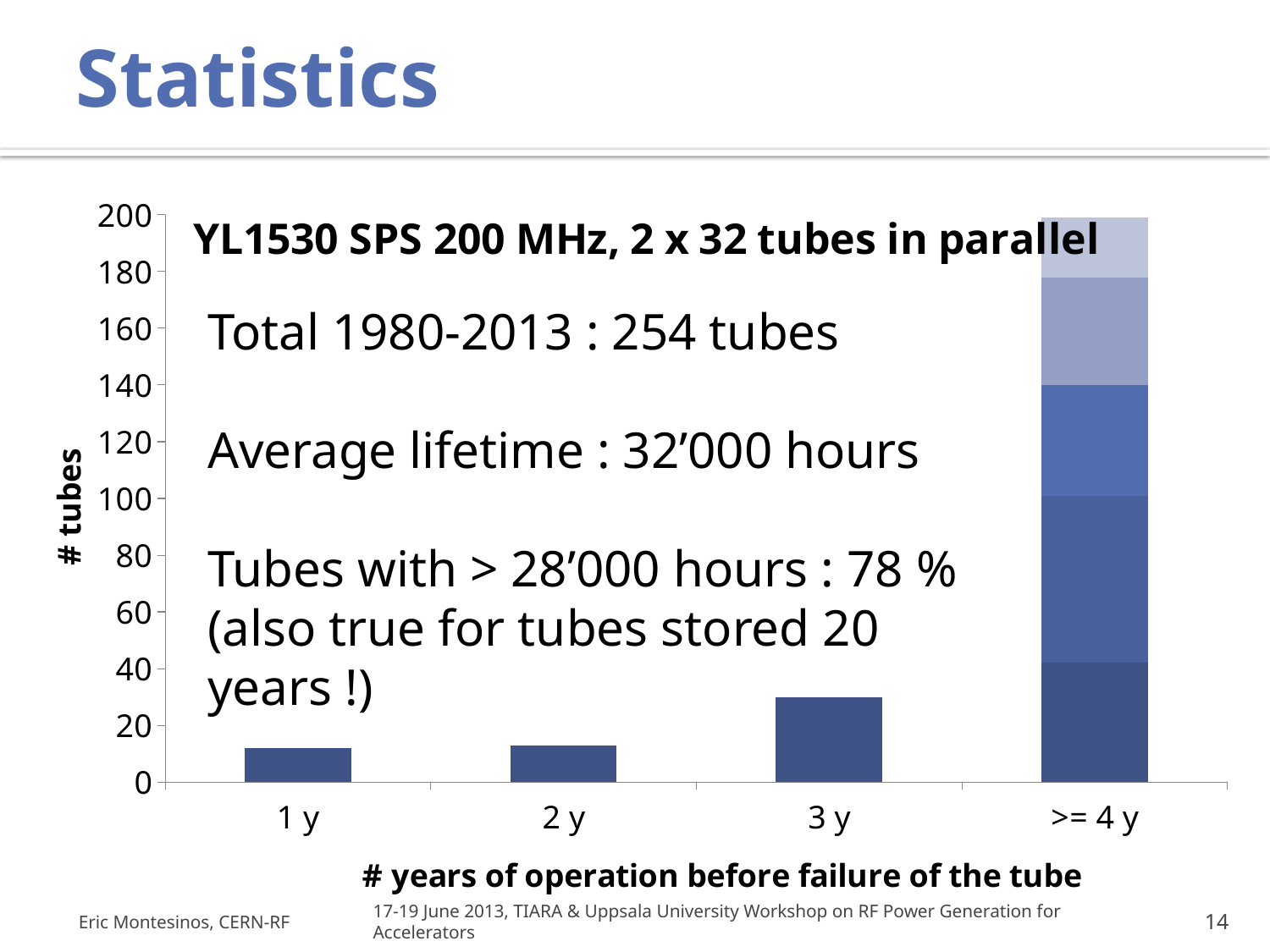
What kind of chart is shown on the slide? bar chart Is the value for >= 4 y greater or less than 180? greater Do the values rise or fall from 1 y to >= 4 y along the x axis? rise Which is larger, the value for 3 y or the value for 1 y? 3 y Which category has the highest number of tubes? >= 4 y Is the value for 2 y greater or less than 20? less How many categories are shown on the x axis of the chart? 4 What is the label of the x axis of the chart? # years of operation before failure of the tube Is the value for 3 y greater or less than 20? greater What is the title of the chart? YL1530 SPS 200 MHz, 2 x 32 tubes in parallel